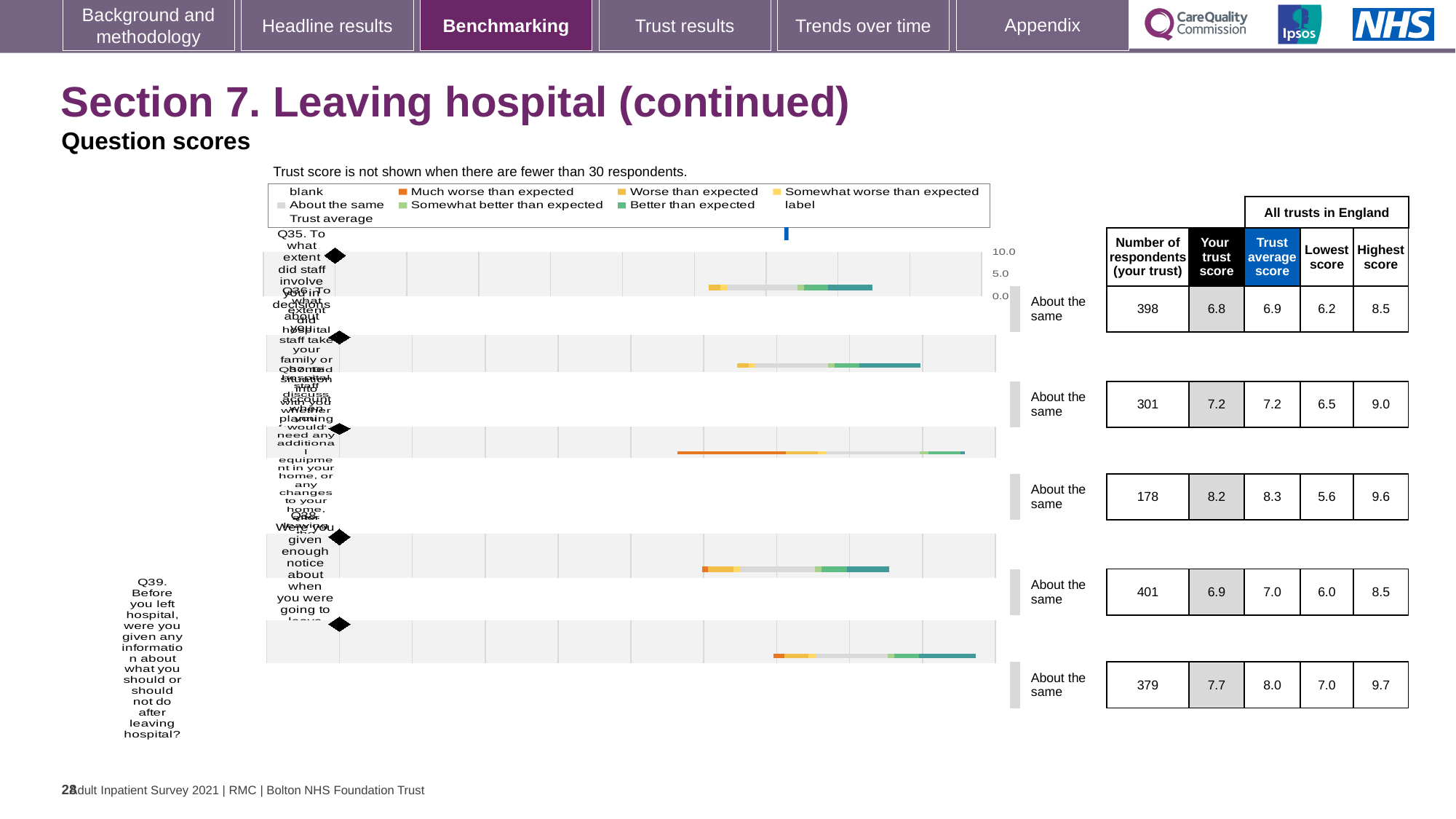
How many questions are benchmarked on this slide? 5 What is the lowest score among all trusts in England for Q37? 5.6 What is the difference between the trust average score and your trust score for Q39? 0.3 How many respondents from the trust answered Q35? 398 Which question has the lowest 'Your trust score' on this slide? Q35 Which is larger for Q36: your trust score or the lowest score in England? Your trust score Which question has the highest 'Your trust score' on this slide? Q37 What is the highest score among all trusts in England for Q39? 9.7 What is the trust score for Q39 (Before you left hospital, were you given any information about what you should or should not do after leaving hospital?)? 7.7 What benchmark category is shown for Q38 (Were you given enough notice about when you were going to leave)? About the same What kind of chart is used to show the benchmarking results on this slide? Bar chart What is the trust average score for all trusts in England for Q37? 8.3